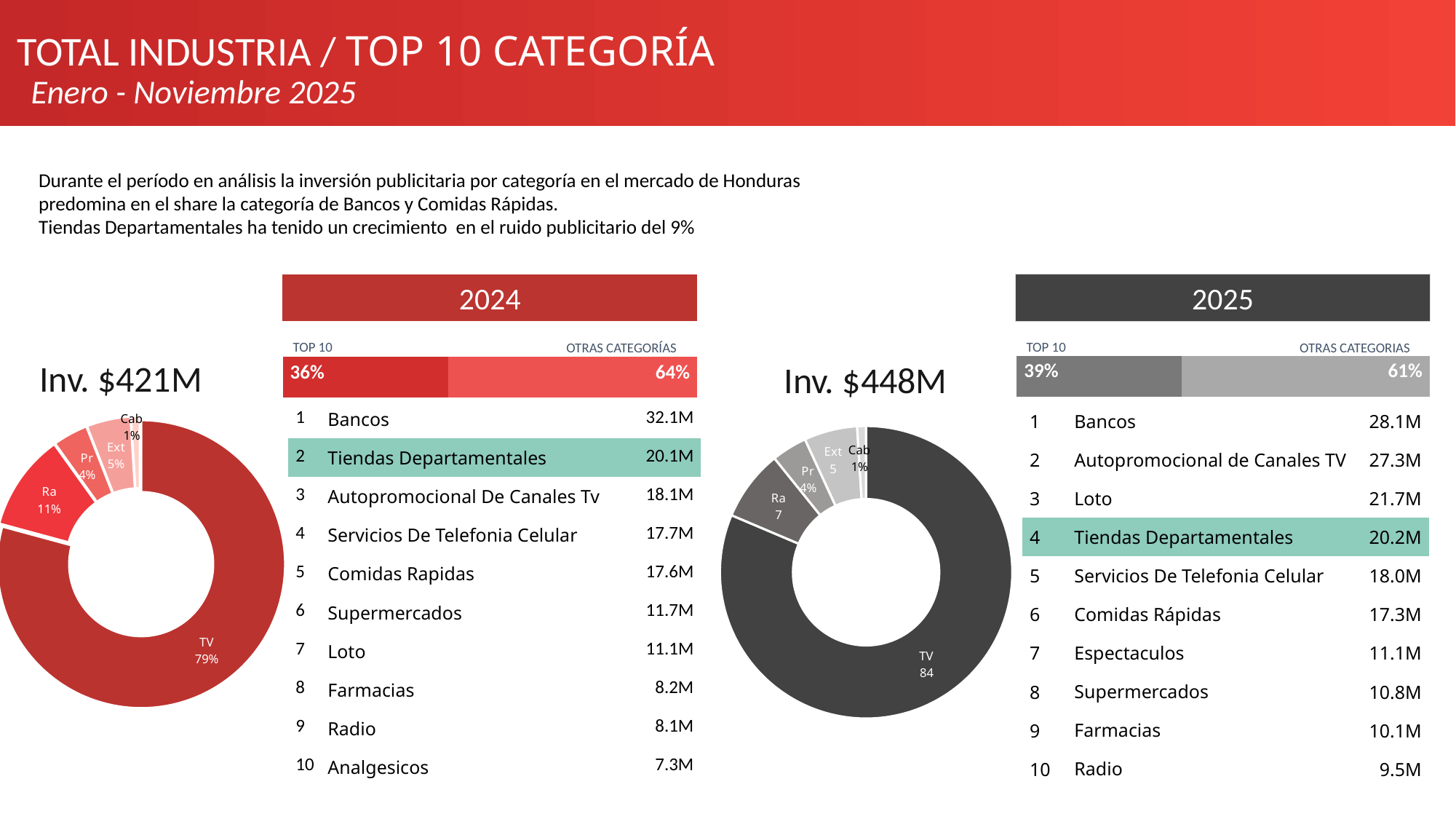
In the 2024 pie chart (under Inv. $421M), which slice is the largest? TV In the 2024 stacked bar, what share is shown for TOP 10? 36% In the 2024 pie chart (under Inv. $421M), what share does TV have? 79% In the 2025 pie chart (under Inv. $448M), what value is shown for TV? 84 In the 2025 pie chart (under Inv. $448M), what value is shown for Ra? 7 What kind of chart is shown under "Inv. $421M" on the left of the slide? doughnut chart In the 2025 stacked bar, what share is shown for OTRAS CATEGORIAS? 61% In the 2024 pie chart (under Inv. $421M), what share does Ra have? 11% How many slices does the 2024 pie chart (under Inv. $421M) have? 5 By how many percentage points does the TV share in the 2025 pie chart exceed the TV share in the 2024 pie chart? 5 In the 2024 pie chart (under Inv. $421M), which slice is the smallest? Cab Is the TV share larger in the 2024 pie chart or in the 2025 pie chart? 2025